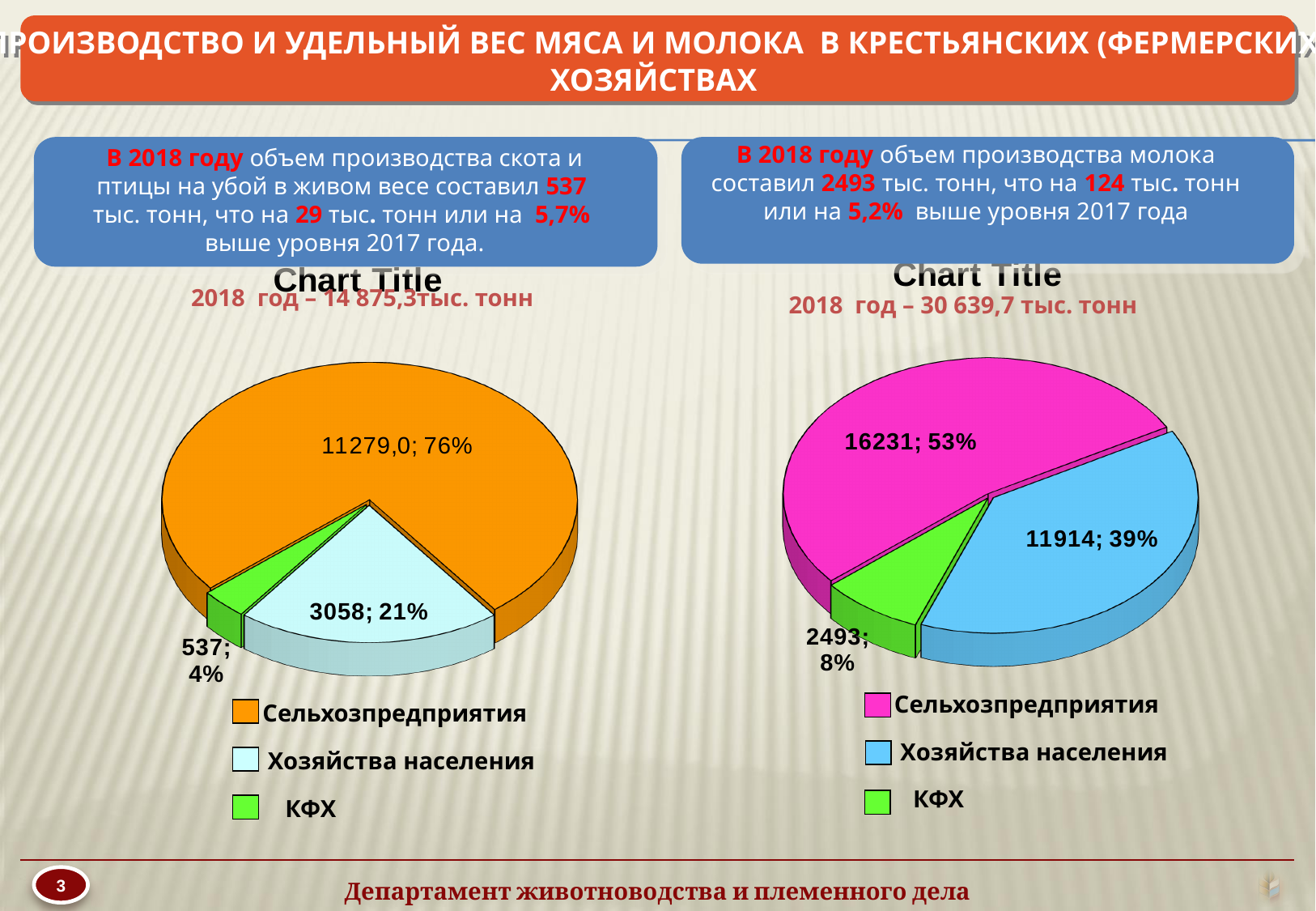
How many slices does the left pie chart have? 3 In the left pie chart, which category has the smallest slice? КФХ In the right pie chart, what share of the pie does КФХ have? 8% In the right pie chart, what is the difference between the values for Сельхозпредприятия and Хозяйства населения? 4317 How many entries does the legend of the right pie chart list? 3 In the right pie chart, what value is shown for Сельхозпредприятия? 16231; 53% In the right pie chart, what value is shown for Хозяйства населения? 11914; 39% In the right pie chart, which category has the largest slice? Сельхозпредприятия What kind of chart is the left chart on the slide? pie chart In the left pie chart, what value is shown for Сельхозпредприятия? 11279,0; 76% In the left pie chart, what share of the pie does Хозяйства населения have? 21% In the left pie chart, what value is shown for КФХ? 537; 4%